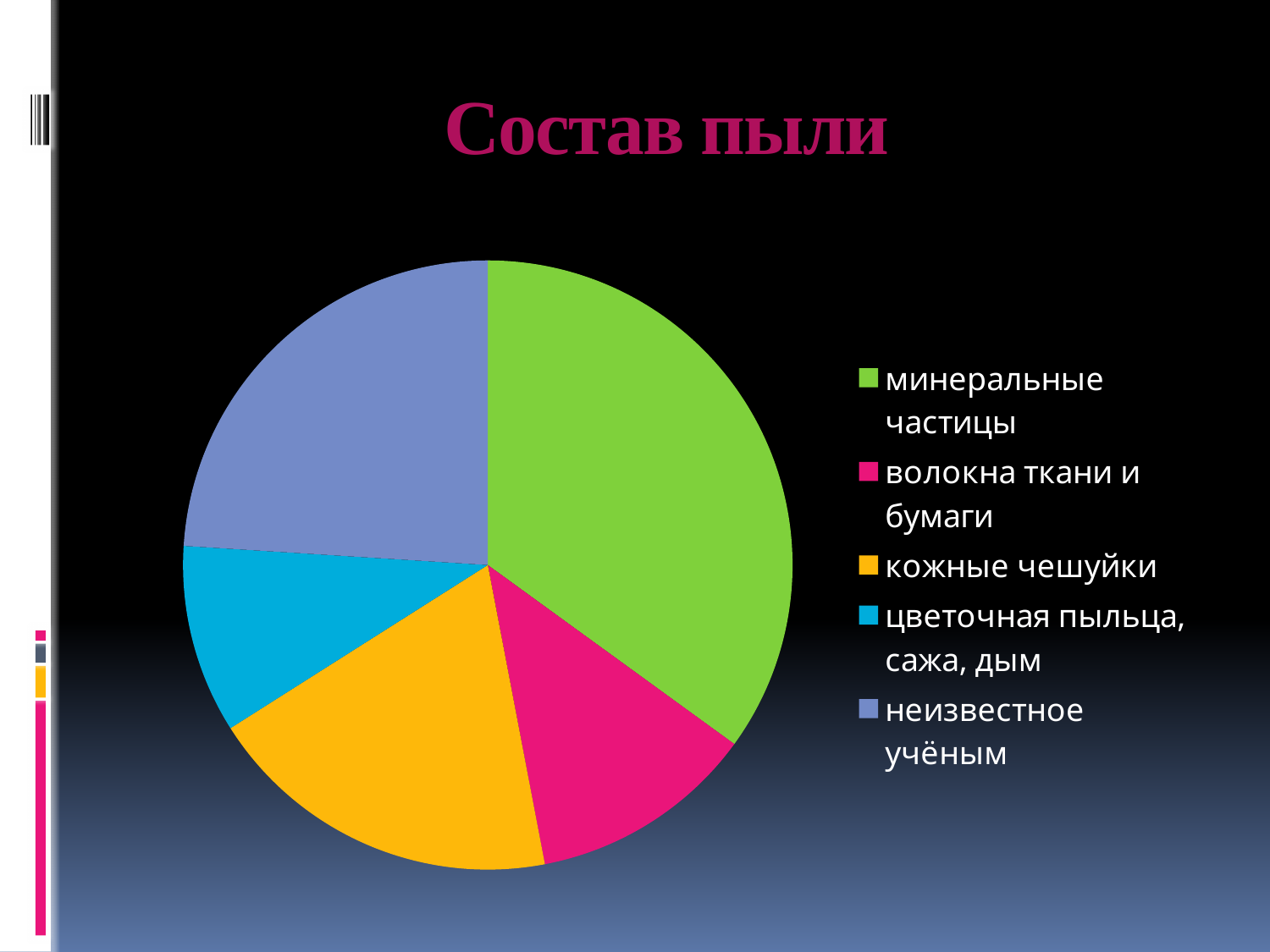
What is the title of the chart? Состав пыли Which category has the largest slice of the pie? минеральные частицы Which slice is larger: кожные чешуйки or волокна ткани и бумаги? кожные чешуйки What kind of chart is shown on the slide? pie chart Which category is shown in green in the pie chart? минеральные частицы Which slice is larger: минеральные частицы or неизвестное учёным? минеральные частицы How many slices does the pie chart have? 5 Which category has the smallest slice of the pie? цветочная пыльца, сажа, дым Which slice is larger: неизвестное учёным or кожные чешуйки? неизвестное учёным